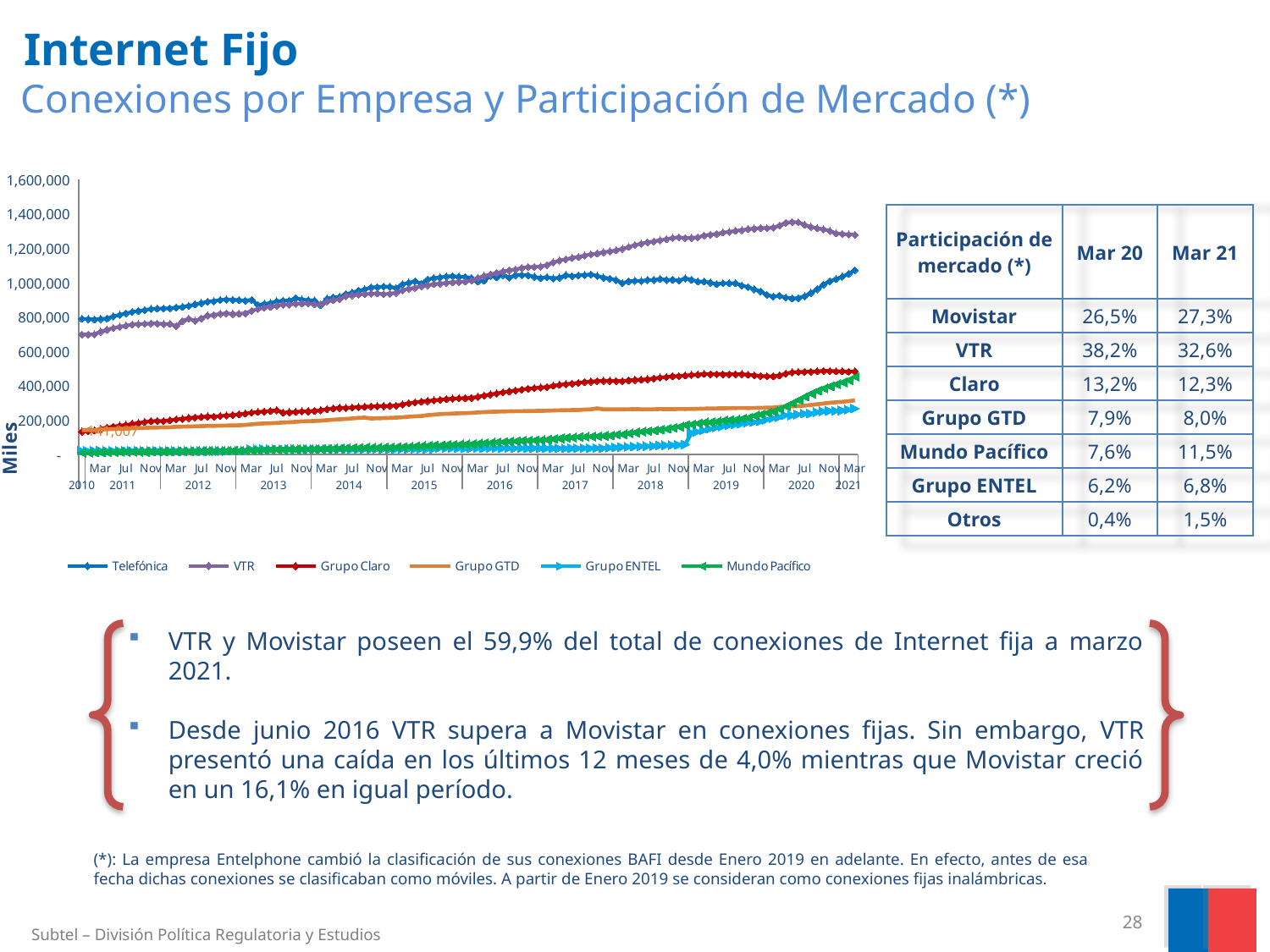
Is the value for Grupo Claro at Mar 2021 greater or less than 400,000? greater Does the Grupo Claro series rise or fall overall from 2010 to 2021? rise What is the label on the vertical axis of the chart? Miles How many series does the chart legend list? 6 Is the value for Telefónica at the start of 2010 greater or less than 1,000,000? less Which series has the highest value at the start of the chart in 2010? Telefónica At Mar 2021, which is larger: VTR or Telefónica? VTR Which series has the highest value at the end of the chart (Mar 2021)? VTR What kind of chart is shown on the slide? line chart Is the value for VTR at Mar 2021 greater or less than 1,200,000? greater